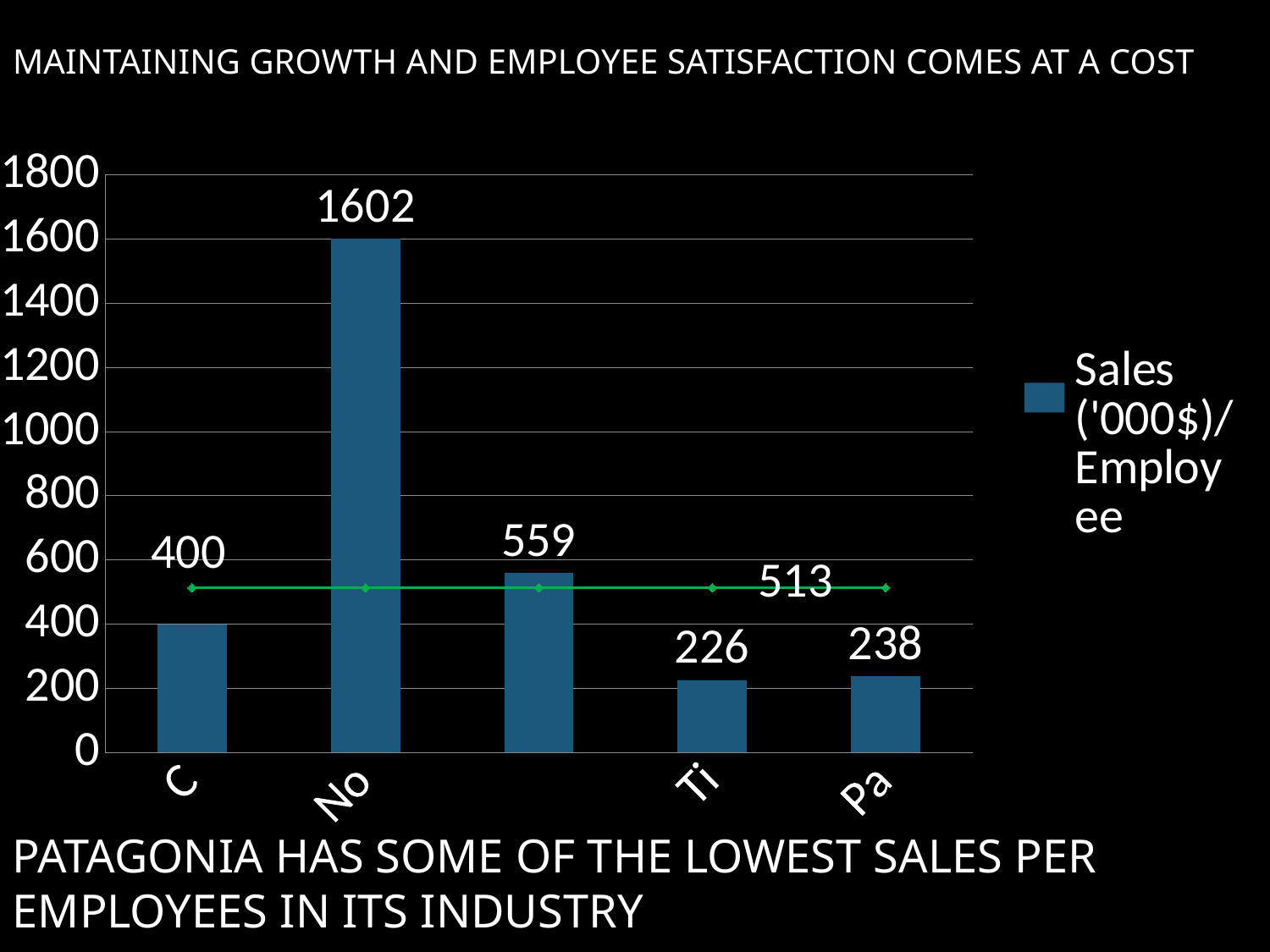
Which bar has the highest value in the chart? No (the second bar) What is the value of the third bar from the left? 559 What value is labelled on the green horizontal line across the chart? 513 Is the value of the bar labelled 'No' greater or less than 1400? greater What kind of chart is shown on the slide? combination bar and line chart What is the value of the bar labelled 'Pa'? 238 Which bar has the lowest value in the chart? Ti (the fourth bar) What is the value of the highest bar in the chart? 1602 What is the difference between the value of the bar labelled 'No' and the bar labelled 'C'? 1202 How many bars are plotted in the chart? 5 Which is larger, the value for 'C' or the value for 'Pa'? C What is the value of the bar labelled 'C'? 400